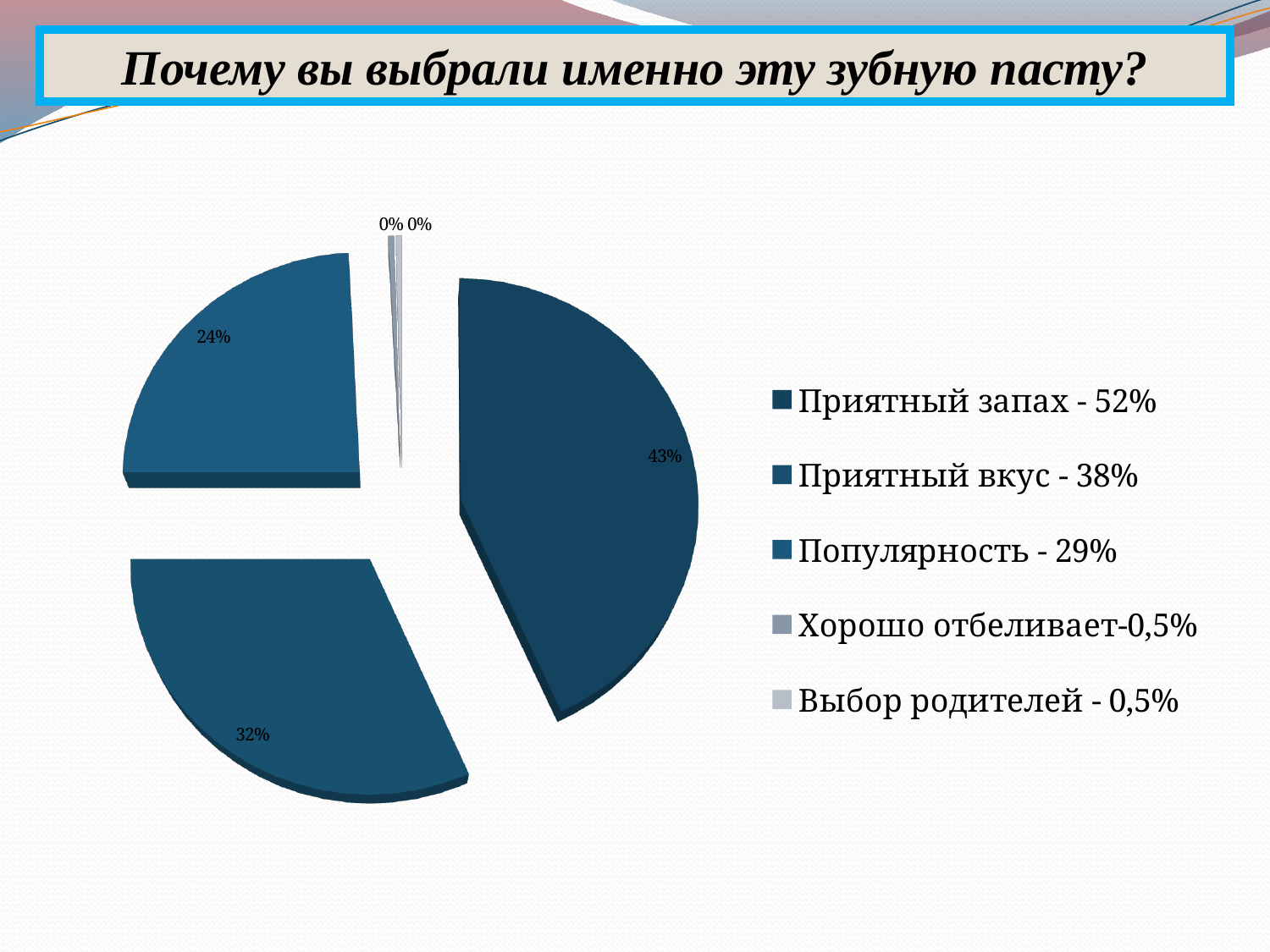
Which slice is larger: Приятный вкус or Популярность? Приятный вкус What is the title of the slide above the chart? Почему вы выбрали именно эту зубную пасту? How many entries does the legend list? 5 What percentage label is shown on the Хорошо отбеливает slice? 0% What percentage label is shown on the largest slice of the pie chart? 43% What value is written in the legend entry for Выбор родителей? 0,5% What percentage label is shown on the Популярность slice? 24% What is the difference between the labels on the Приятный запах slice (43%) and the Приятный вкус slice (32%)? 11% What percentage label is shown on the Приятный вкус slice? 32% How many slices does the pie chart have? 5 Which legend category corresponds to the largest slice of the pie chart? Приятный запах What type of chart is shown on the slide? pie chart